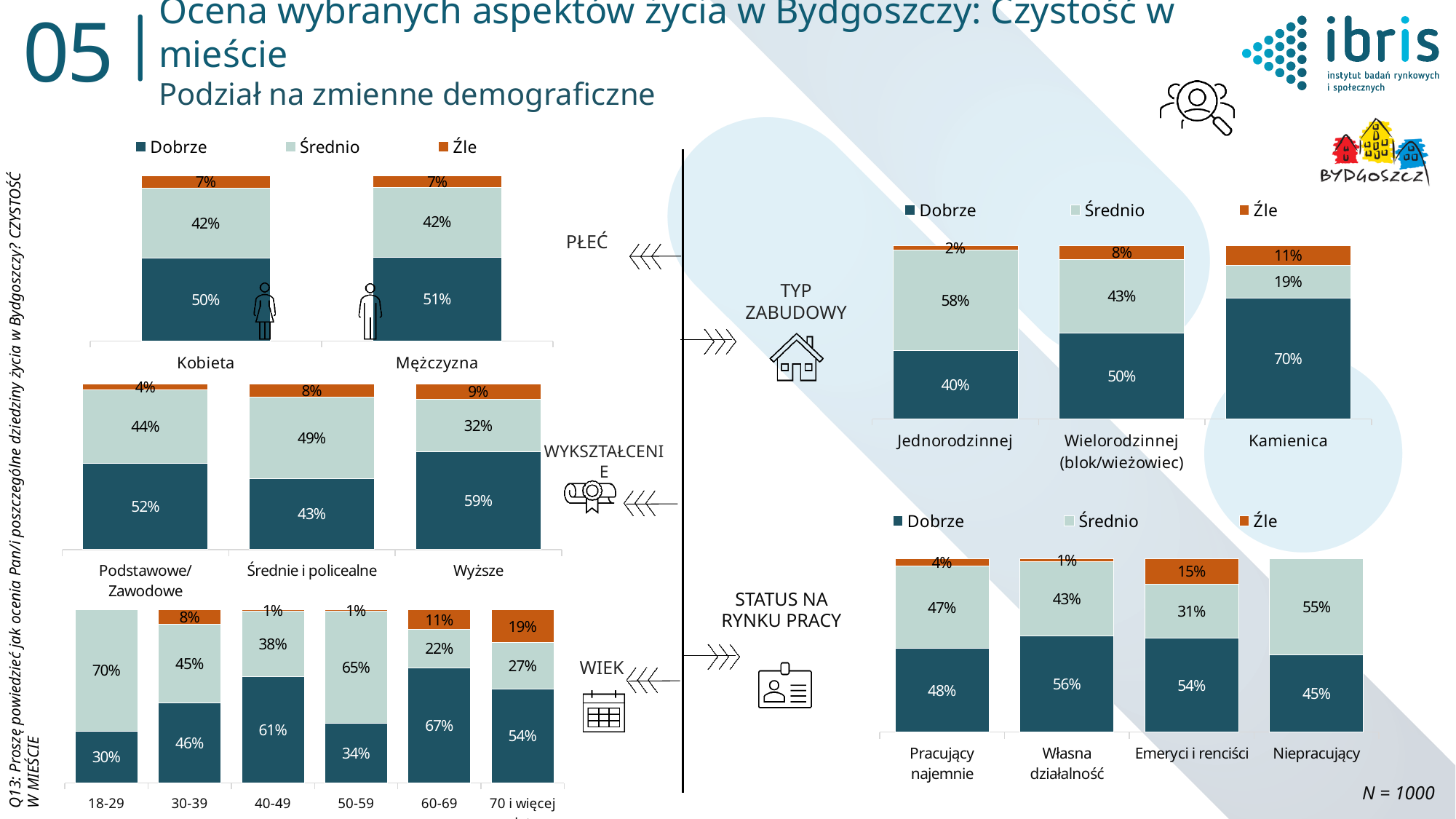
In the TYP ZABUDOWY chart, what is the Dobrze value for Kamienica? 70% What kind of chart is the WIEK chart? Stacked bar chart In the WIEK chart, which age group has the highest Dobrze value? 60-69 In the WYKSZTAŁCENIE chart, which education group has the lowest Dobrze value? Średnie i policealne In the TYP ZABUDOWY chart, which building type has the highest Źle value? Kamienica In the WIEK chart, what is the Średnio value for the 18-29 age group? 70% In the TYP ZABUDOWY chart, which has the larger Średnio value: Jednorodzinnej or Wielorodzinnej (blok/wieżowiec)? Jednorodzinnej In the STATUS NA RYNKU PRACY chart, what is the Dobrze value for Własna działalność? 56% How many categories are shown in the STATUS NA RYNKU PRACY chart? 4 How many series does the legend of the PŁEĆ chart list? 3 In the WYKSZTAŁCENIE chart, what is the total of the Wyższe bar? 100% In the STATUS NA RYNKU PRACY chart, what is the difference between the Źle value for Emeryci i renciści and the Źle value for Pracujący najemnie? 11 percentage points